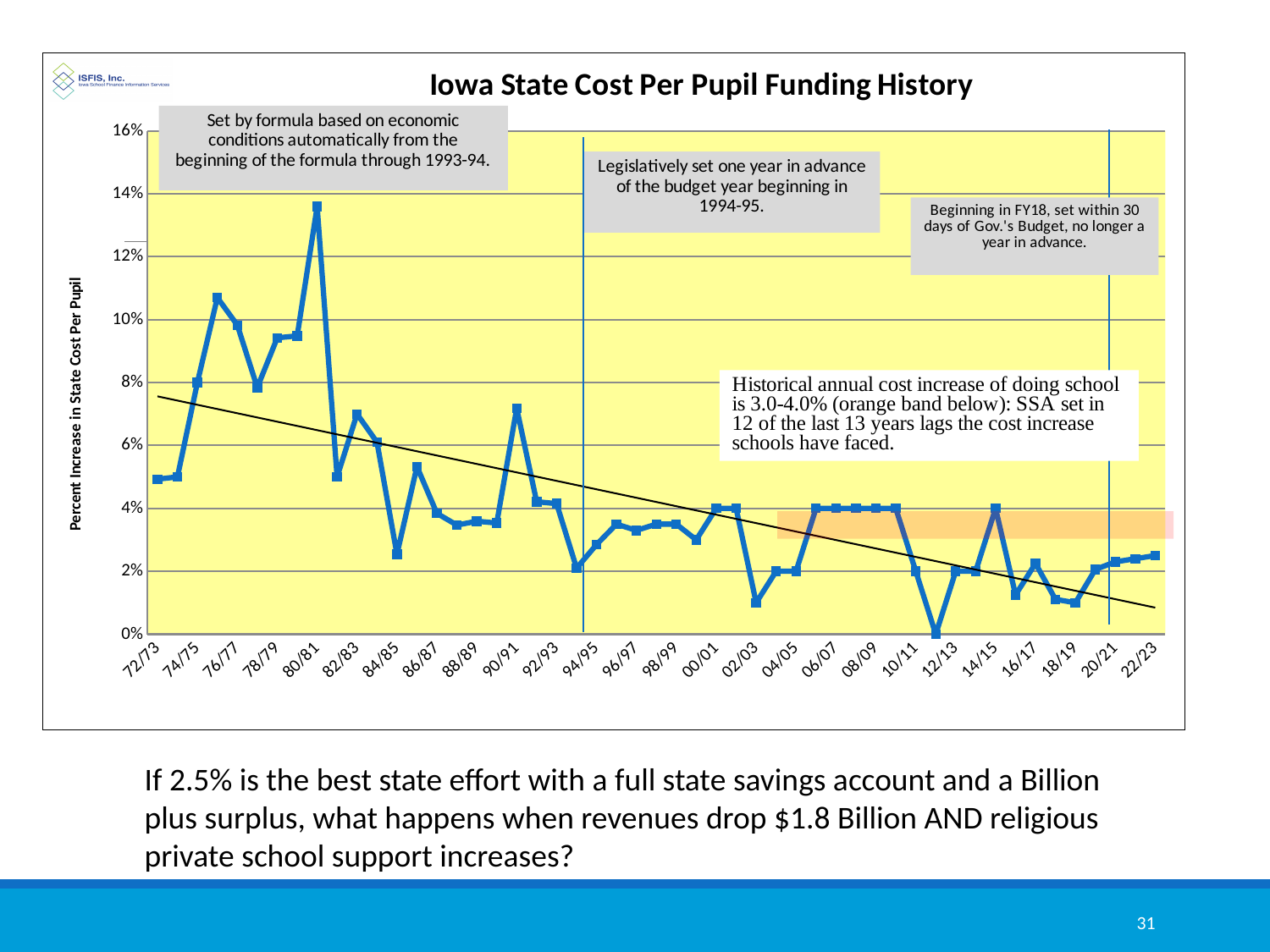
Which year has the highest percent increase in state cost per pupil? 80/81 What is the label on the vertical axis of the chart? Percent Increase in State Cost Per Pupil Overall, do the percent increases rise or fall from 72/73 to 22/23? fall Is the value for 76/77 greater or less than 8%? greater What is the title of the chart? Iowa State Cost Per Pupil Funding History Which year has a larger percent increase, 76/77 or 86/87? 76/77 Is the value for 02/03 greater or less than 2%? less Is the value for 22/23 greater or less than 4%? less What kind of chart is shown on the slide? line chart Which year has the lowest percent increase in state cost per pupil? 11/12